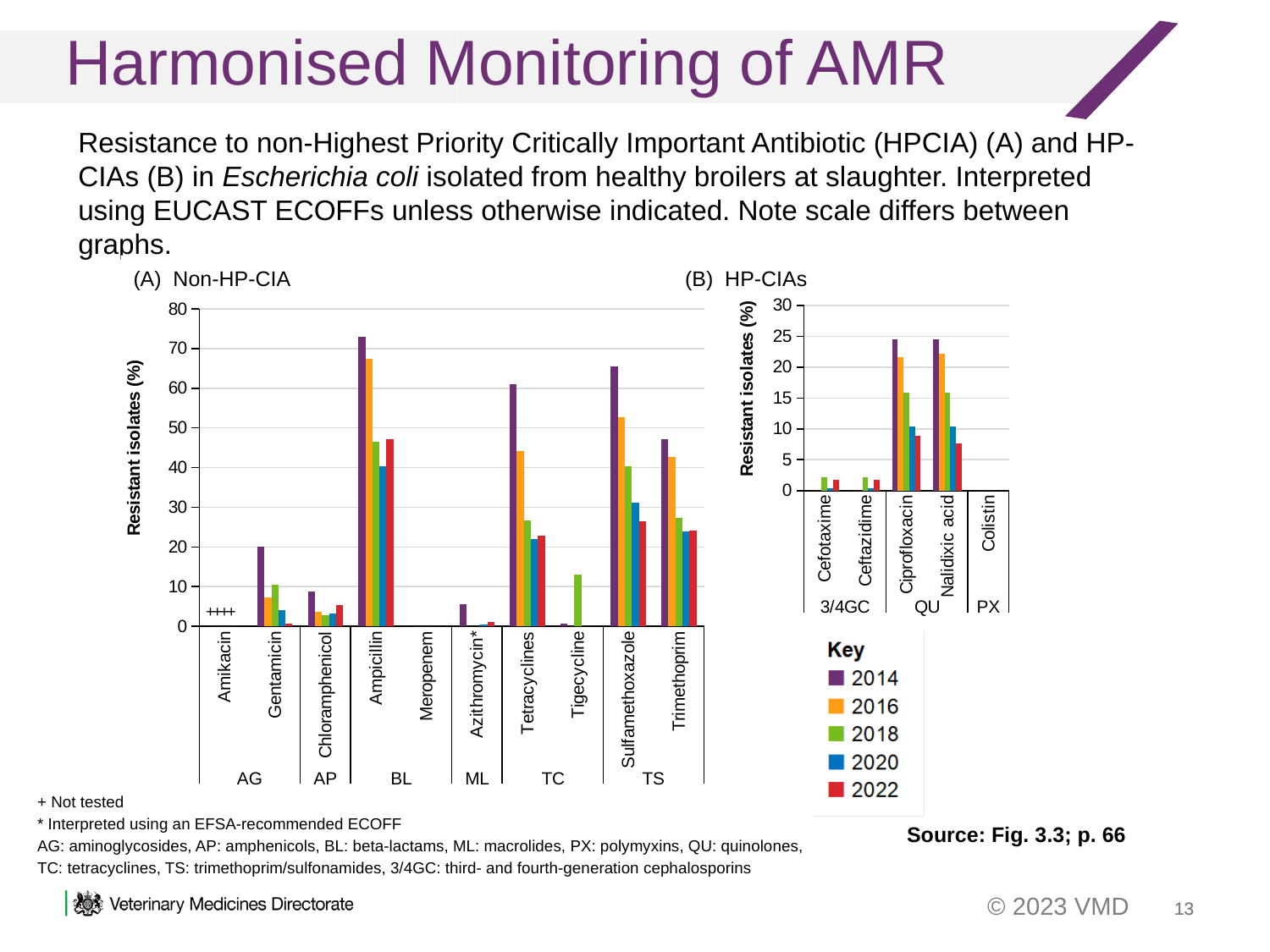
How many antibiotics are shown on the x axis of chart (B) HP-CIAs? 5 How many antibiotics are shown on the x axis of chart (A) Non-HP-CIA? 10 How many years does the key list as series? 5 What kind of chart is chart (A) Non-HP-CIA? bar chart What is the y-axis label on chart (B) HP-CIAs? Resistant isolates (%) In chart (B) HP-CIAs, is the 2014 value for Ciprofloxacin greater or less than 20? greater In chart (A) Non-HP-CIA, is the 2014 value for Sulfamethoxazole greater or less than 60? greater In chart (A) Non-HP-CIA, which antibiotic has the highest bar overall? Ampicillin In chart (A) Non-HP-CIA, is the 2014 value for Ampicillin greater or less than 70? greater In chart (A) Non-HP-CIA, which is larger: the 2014 value for Ampicillin or the 2014 value for Sulfamethoxazole? Ampicillin In chart (A) Non-HP-CIA, do the values for Sulfamethoxazole rise or fall from 2014 to 2022? fall